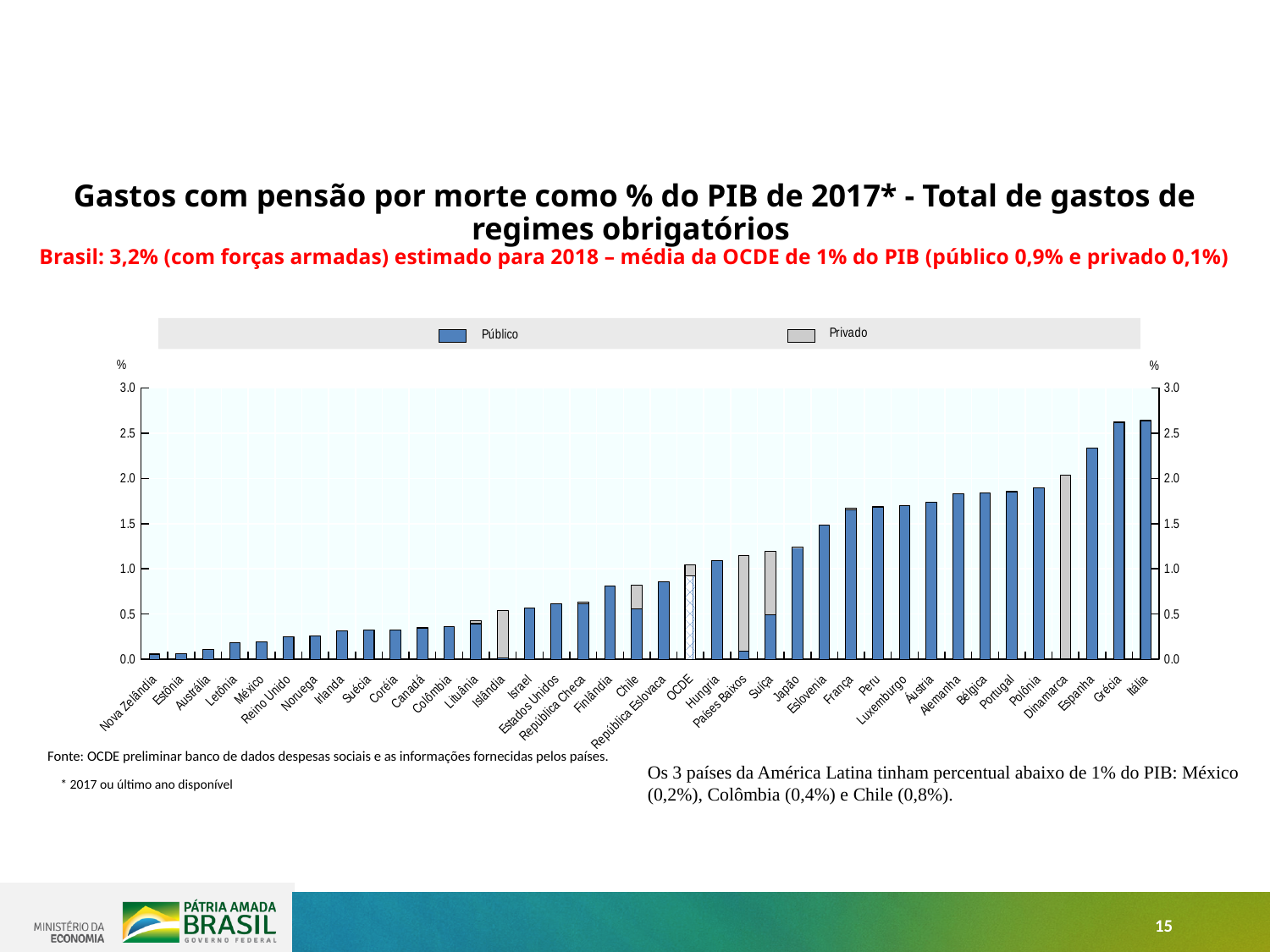
Do the bar values generally rise or fall from left to right along the x axis? rise Is the value for Itália greater or less than 2.5? greater According to the slide, what is México's spending on survivor pensions as a % of GDP? 0,2% Is the value for Nova Zelândia greater or less than 0.5? less What are the two series named in the legend? Público and Privado According to the slide, what is the OCDE average public (público) spending as a % of GDP? 0,9% Is the value for Japão greater or less than 1.0? greater According to the slide, what is Chile's spending on survivor pensions as a % of GDP? 0,8% According to the slide, what is Brazil's estimated spending for 2018 as a % of GDP? 3,2% How many series does the legend list? 2 Which has the larger total value, Espanha or Polônia? Espanha What kind of chart is shown on the slide? bar chart